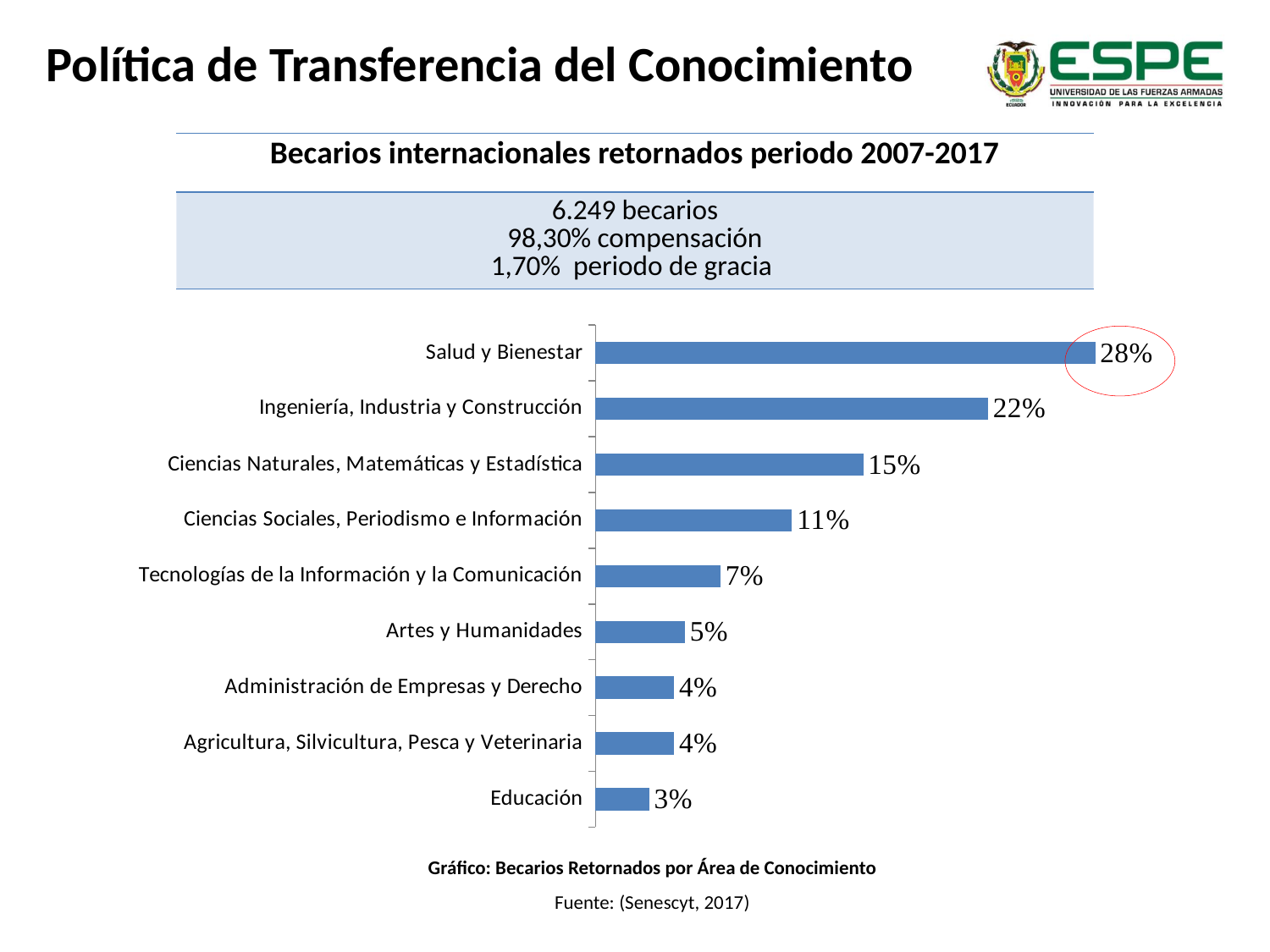
What percentage is shown for Educación? 3% What kind of chart is shown on the slide? Bar chart Which area of knowledge has the highest percentage of returned scholarship holders? Salud y Bienestar What percentage is shown for Salud y Bienestar? 28% Which is larger, the value for Ingeniería, Industria y Construcción or the value for Ciencias Naturales, Matemáticas y Estadística? Ingeniería, Industria y Construcción How many areas of knowledge are shown in the chart? 9 What is the difference in percentage points between Ciencias Sociales, Periodismo e Información and Artes y Humanidades? 6 What percentage is shown for Tecnologías de la Información y la Comunicación? 7% What is the difference in percentage points between Salud y Bienestar and Ingeniería, Industria y Construcción? 6 Which area of knowledge has the lowest percentage? Educación What is the caption given below the chart? Gráfico: Becarios Retornados por Área de Conocimiento What percentage is shown for Ciencias Naturales, Matemáticas y Estadística? 15%